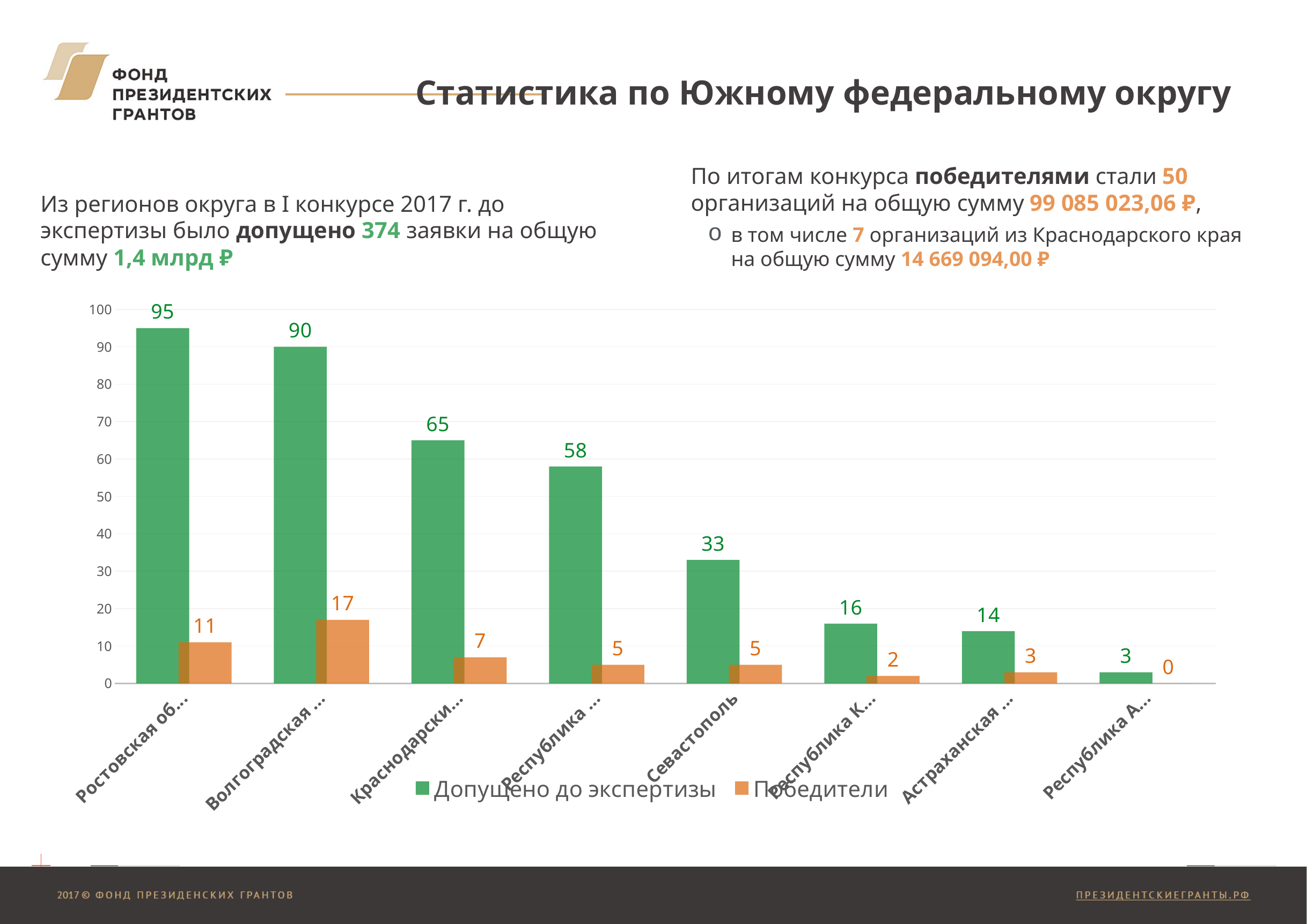
What is the value of Победители for Краснодарский край? 7 What is the value of Допущено до экспертизы for Севастополь? 33 What is the value of Победители for Севастополь? 5 What is the value of Победители for the last category on the right of the chart? 0 What is the difference between Допущено до экспертизы and Победители for Ростовская область? 84 How many series does the legend list? 2 Which has more Победители: Волгоградская область or Ростовская область? Волгоградская область Which category has the highest value of Победители? Волгоградская область Which category has the highest value of Допущено до экспертизы? Ростовская область What is the value of Допущено до экспертизы for Астраханская область? 14 Do the values of Допущено до экспертизы rise or fall from left to right along the x axis? fall How many categories (regions) are shown on the chart? 8